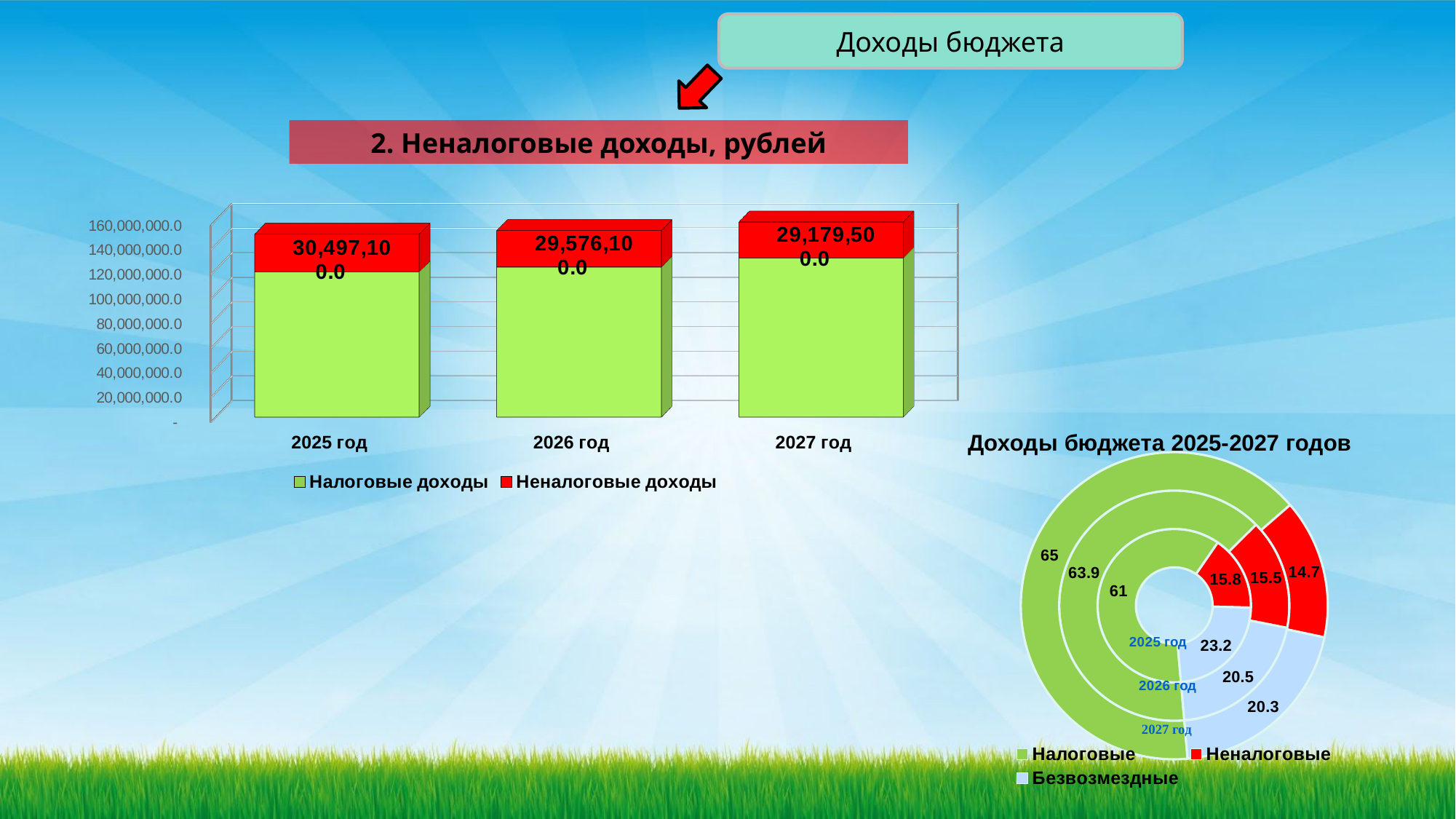
In the chart 'Доходы бюджета 2025-2027 годов', which year has the lowest Неналоговые value? 2027 год In the bar chart '2. Неналоговые доходы, рублей', do the Неналоговые доходы values rise or fall from 2025 год to 2027 год? fall In the bar chart '2. Неналоговые доходы, рублей', how many series does the legend list? 2 In the bar chart '2. Неналоговые доходы, рублей', what is the difference between the Неналоговые доходы values for 2025 год and 2026 год? 921,000.0 In the bar chart '2. Неналоговые доходы, рублей', how many years are shown on the x axis? 3 In the chart 'Доходы бюджета 2025-2027 годов', what is the Налоговые value for 2025 год? 61 In the bar chart '2. Неналоговые доходы, рублей', what is the value of Неналоговые доходы for 2025 год? 30,497,100.0 In the bar chart '2. Неналоговые доходы, рублей', what is the value of Неналоговые доходы for 2027 год? 29,179,500.0 In the chart 'Доходы бюджета 2025-2027 годов', what is the Безвозмездные value for 2027 год? 20.3 In the bar chart '2. Неналоговые доходы, рублей', is the total height of the 2027 год bar greater or less than 100,000,000.0? greater In the bar chart '2. Неналоговые доходы, рублей', which year has the highest Неналоговые доходы value? 2025 год What kind of chart is 'Доходы бюджета 2025-2027 годов'? doughnut chart